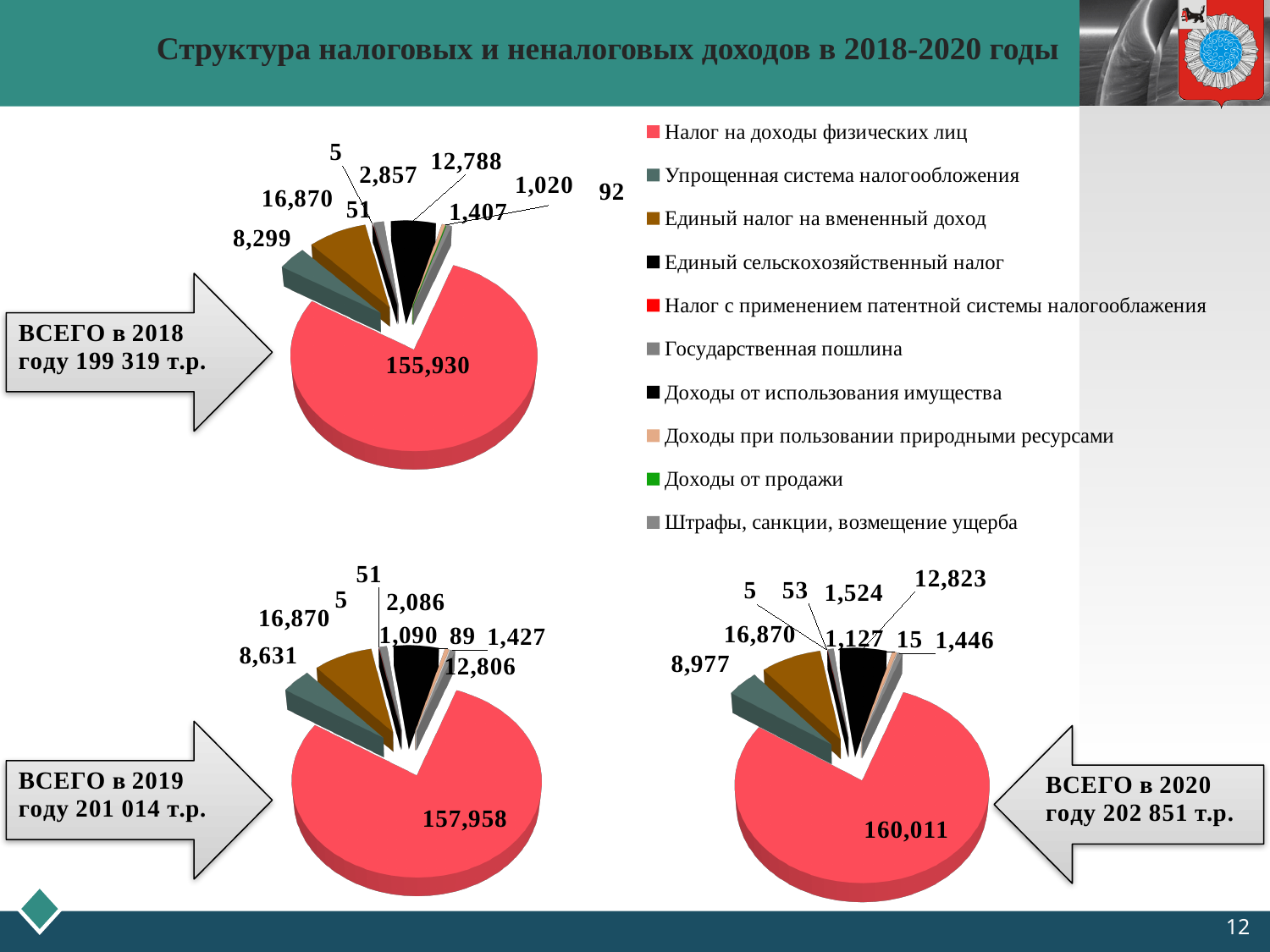
What type of chart is used on this slide to show the structure of revenues? pie chart By how much does the value for Налог на доходы физических лиц in the 2020 pie chart exceed the value in the 2018 pie chart? 4,081 Which is larger: the Упрощенная система налогообложения slice in the 2018 pie chart or in the 2020 pie chart? 2020 In the 2020 pie chart (bottom right), what is the value for Налог на доходы физических лиц? 160,011 In the 2018 pie chart (top left), what is the value of the largest slice, Налог на доходы физических лиц? 155,930 In the 2020 pie chart (bottom right), which category has the largest slice? Налог на доходы физических лиц What colour is the largest slice in each of the three pie charts? red In the 2018 pie chart (top left), what is the value for Единый налог на вмененный доход? 16,870 How many entries does the shared legend list? 10 In the 2019 pie chart (bottom left), what is the value for Налог на доходы физических лиц? 157,958 In the 2019 pie chart (bottom left), what is the value for Упрощенная система налогообложения? 8,631 What is the difference between the Налог на доходы физических лиц values in the 2019 and 2018 pie charts? 2,028